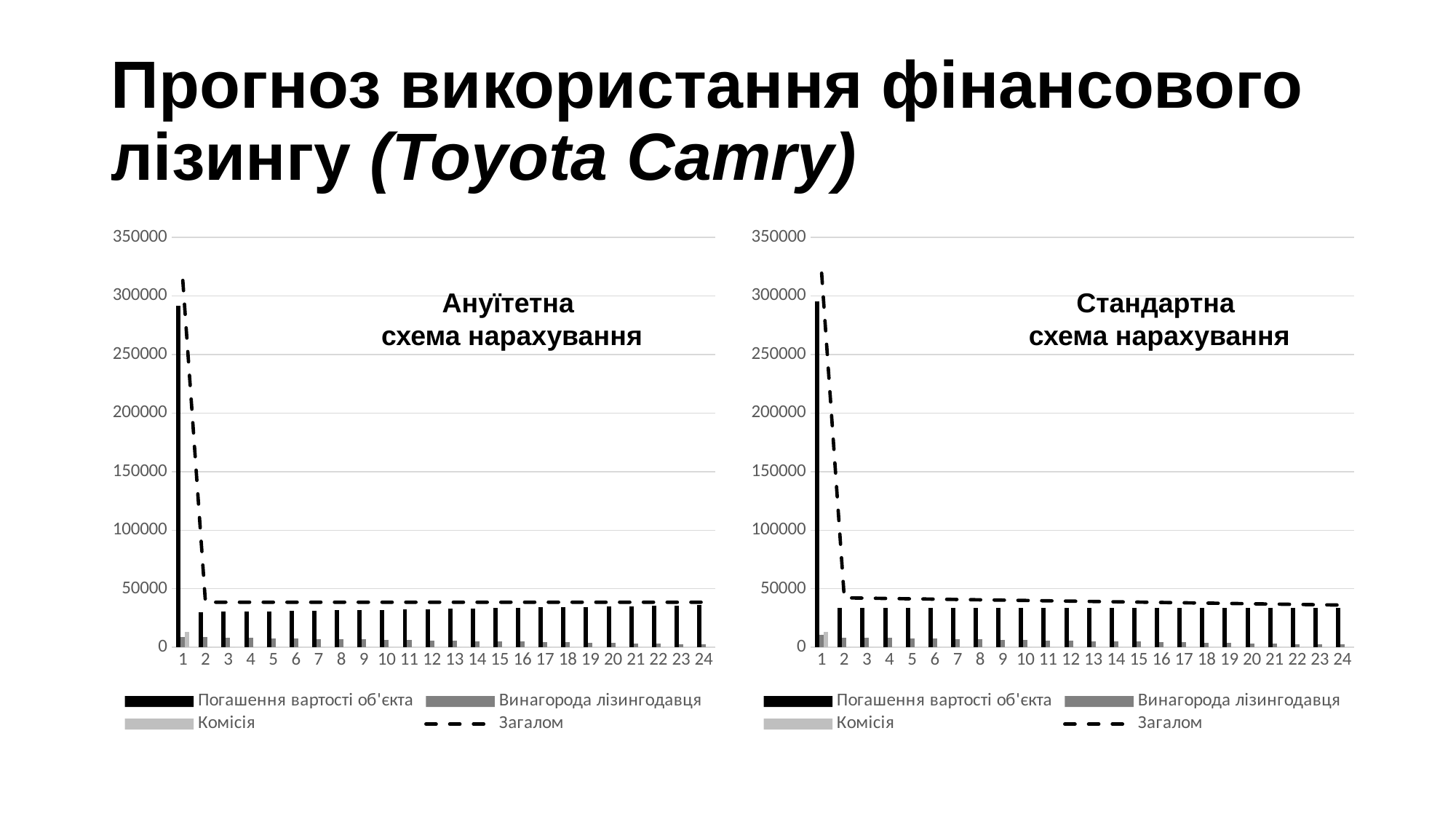
In the right chart (Стандартна схема нарахування), does the Загалом line rise or fall from period 2 to period 24? fall In the left chart (Ануїтетна схема нарахування), is the Погашення вартості об'єкта value in period 12 greater or less than 50000? less What is the title of the right chart? Стандартна схема нарахування Which series is drawn as a dashed line in both charts? Загалом In the left chart (Ануїтетна схема нарахування), does the Загалом line rise or fall from period 1 to period 2? fall In the left chart (Ануїтетна схема нарахування), which period has the highest value for Погашення вартості об'єкта? 1 How many series does the legend of the right chart (Стандартна схема нарахування) list? 4 In the right chart (Стандартна схема нарахування), which is larger: the Загалом value in period 1 or in period 24? period 1 How many periods are shown on the x axis of the left chart (Ануїтетна схема нарахування)? 24 In the right chart (Стандартна схема нарахування), is the Загалом value in period 2 greater or less than 50000? less In the left chart (Ануїтетна схема нарахування), is the Загалом value in period 1 greater or less than 300000? greater